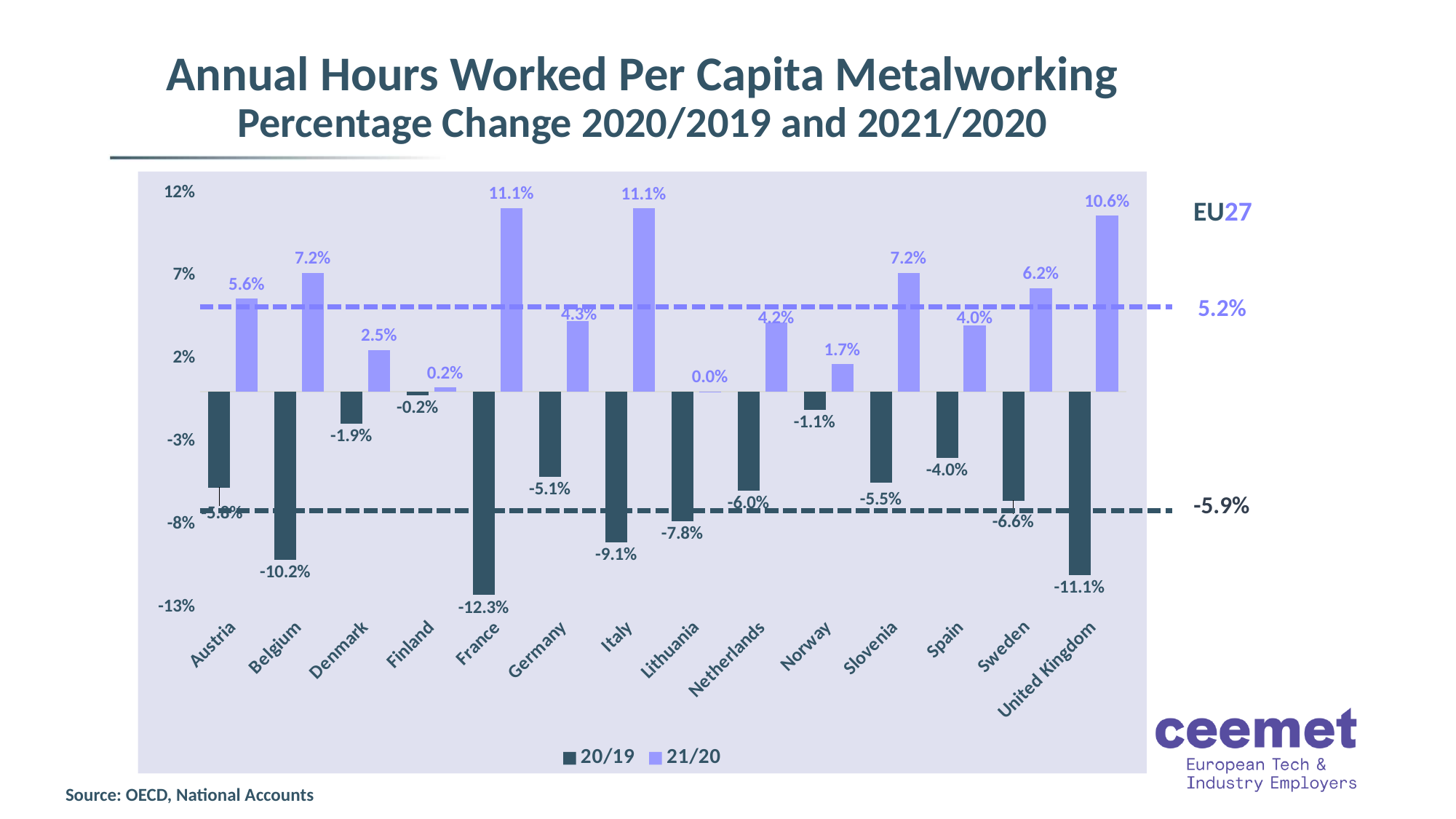
What is the 21/20 percentage change for the United Kingdom? 10.6% What is the 20/19 percentage change for Norway? -1.1% What is the difference between Sweden's and Spain's 21/20 percentage changes? 2.2 percentage points What is the EU27 value shown by the dashed line for 21/20? 5.2% What is the difference between Belgium's and Denmark's 21/20 percentage changes? 4.7 percentage points Which country had the larger decline in 20/19, Italy or Lithuania? Italy How many series does the legend list? 2 What is the 20/19 percentage change for Belgium? -10.2% Is the 21/20 value for Germany greater or less than 7%? less Which country has the lowest 21/20 percentage change? Lithuania Which country has the lowest 20/19 percentage change? France How many countries are shown on the x axis? 14